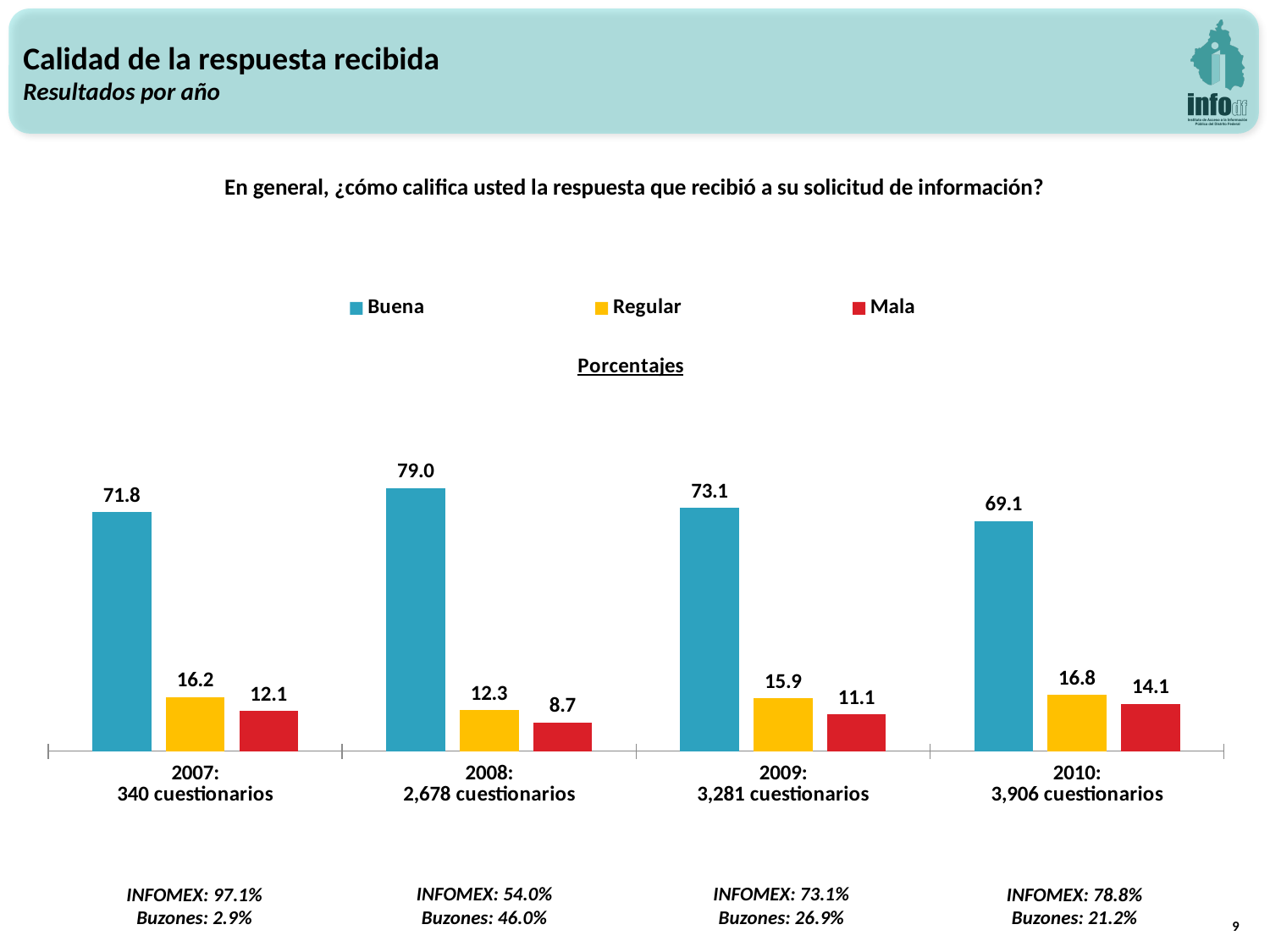
How many years are shown on the x axis? 4 Which colour represents the Mala series in the legend? red What is the value for Mala in 2010? 14.1 In which year is the Buena value highest? 2008 In which year is the Mala value lowest? 2008 Which is larger, the Regular value in 2009 or the Regular value in 2010? 2010 What is the difference between the Buena values for 2008 and 2010? 9.9 How many series does the legend list? 3 What is the value for Buena in 2008? 79.0 What kind of chart is shown? bar chart Does the Buena value rise or fall from 2008 to 2010? fall What is the value for Regular in 2007? 16.2